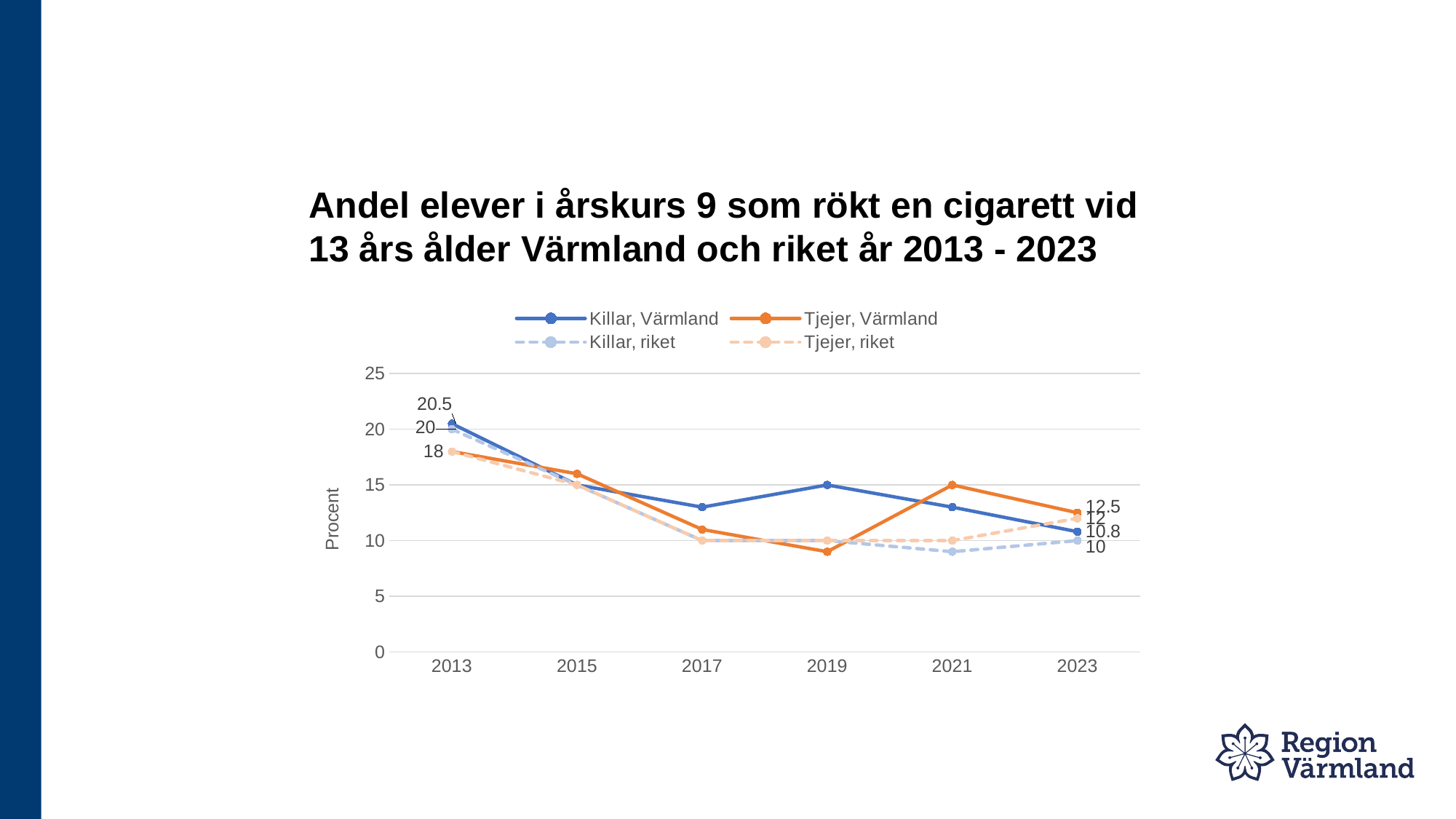
What is the value for Tjejer, Värmland in 2023? 12.5 What is the value for Killar, Värmland in 2023? 10.8 What is the value for Killar, Värmland in 2013? 20.5 What is the label on the y axis? Procent Is the value for Tjejer, Värmland in 2019 greater or less than 10? less What kind of chart is shown on the slide? Line chart How many series does the legend list? 4 How many years are plotted along the x axis? 6 What is the value for Killar, riket in 2023? 10 In 2023, which is higher: Tjejer, Värmland or Killar, Värmland? Tjejer, Värmland By how much did the value for Killar, Värmland fall between 2013 and 2023? 9.7 What is the value for Killar, riket in 2013? 20